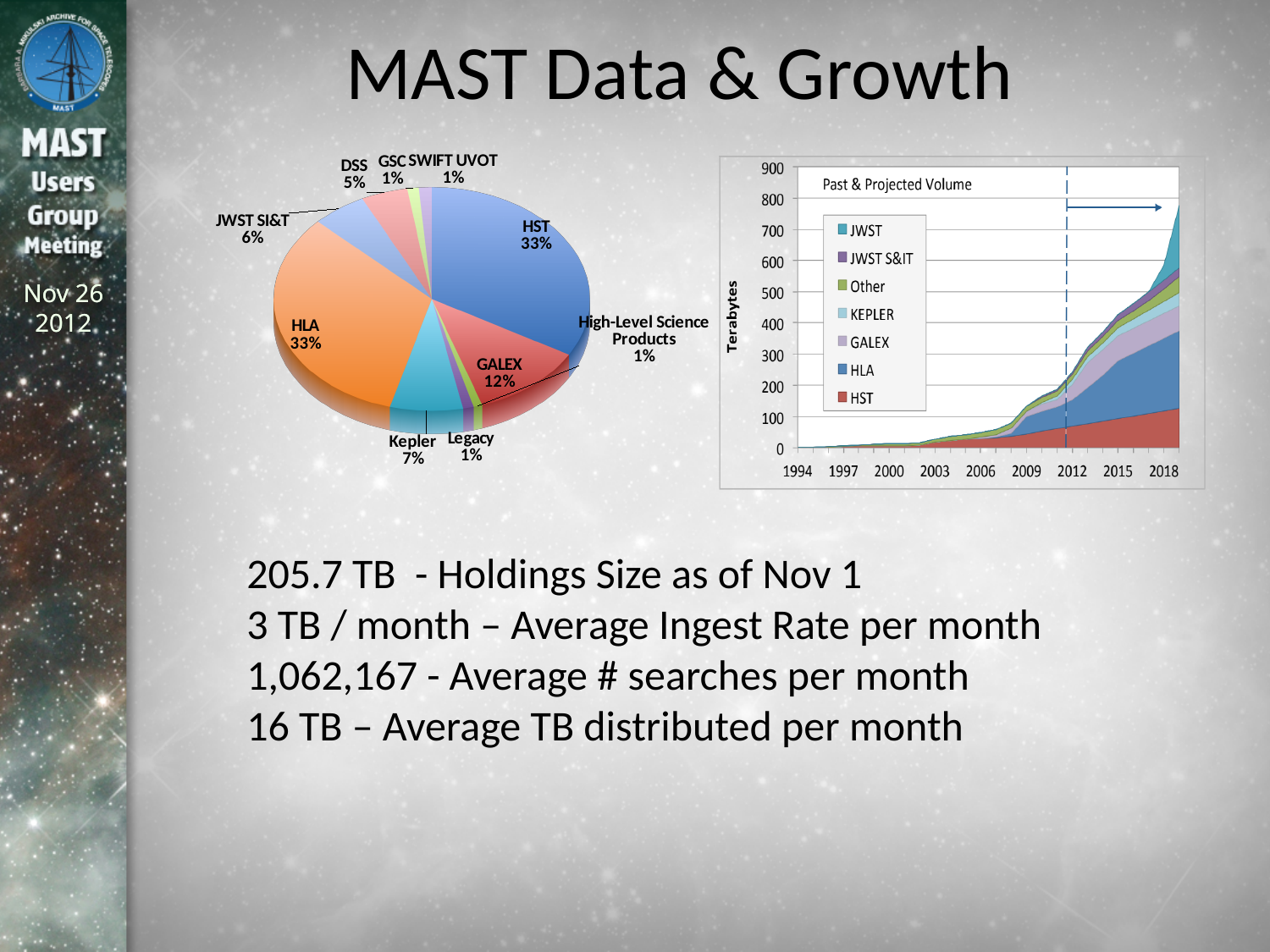
In the Past & Projected Volume chart, is the total volume in 2003 greater or less than 100? less In the pie chart, what percentage is labelled for Kepler? 7% In the Past & Projected Volume chart, does the total volume rise or fall from 1994 to 2018? Rise How many series does the legend of the Past & Projected Volume chart list? 7 In the pie chart, what share of the data is GALEX? 12% In the pie chart, what is the difference between the GALEX share and the Kepler share? 5% In the pie chart, what share is JWST SI&T? 6% How many slices does the pie chart have? 10 In the pie chart, which is larger, DSS or JWST SI&T? JWST SI&T What kind of chart is the chart on the left? Pie chart In the pie chart, which is larger, HLA or GALEX? HLA What kind of chart is the Past & Projected Volume chart? Stacked area chart